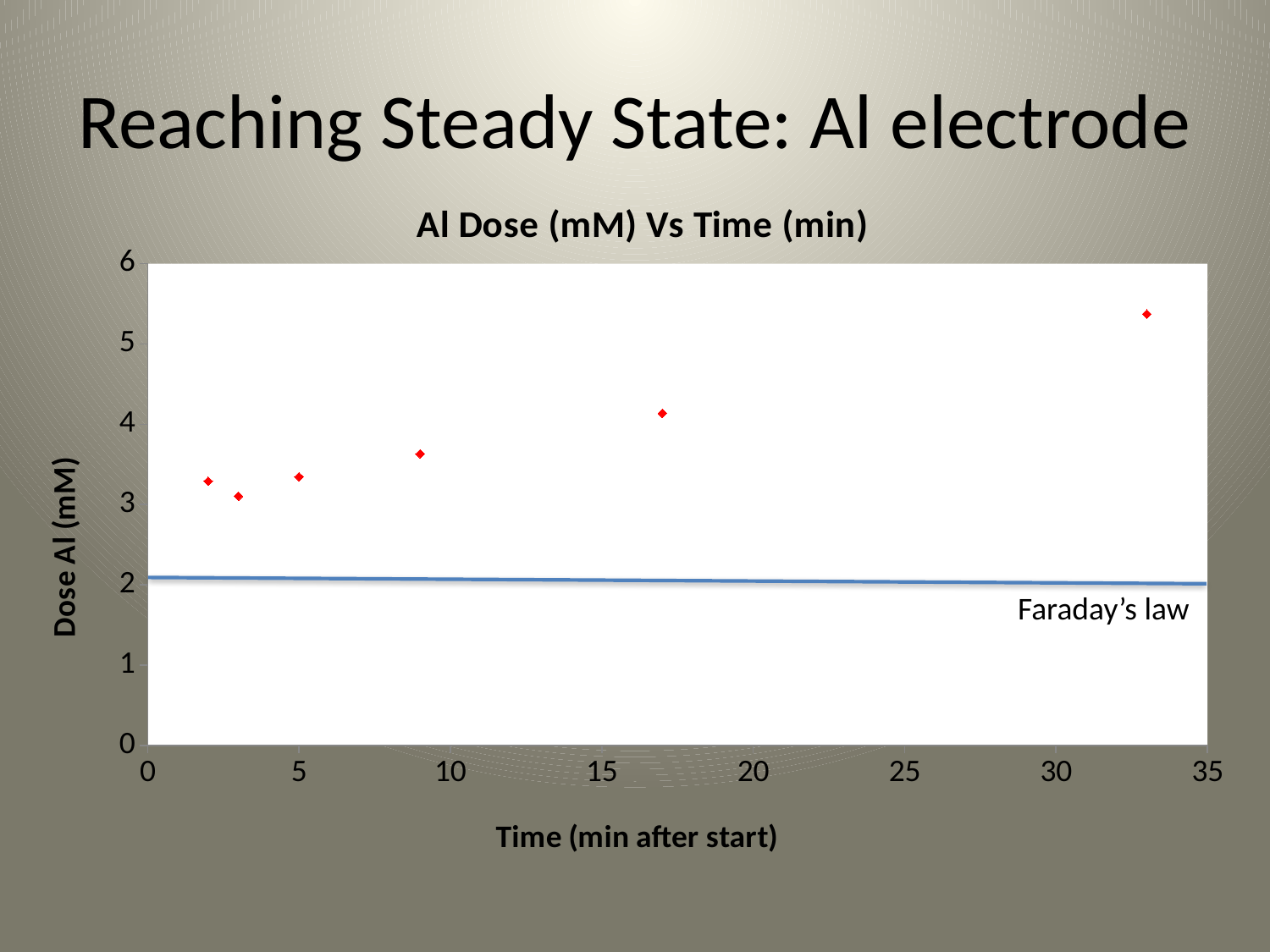
What is the label of the x axis? Time (min after start) Which is larger: the Al dose at about 17 minutes or the Al dose at about 9 minutes? 17 minutes What kind of chart is shown on the slide? scatter chart What is the title of the chart? Al Dose (mM) Vs Time (min) At which time (in minutes) is the plotted Al dose lowest? 3 At which time (in minutes) is the plotted Al dose highest? 33 Is the Faraday's law line greater or less than 3 mM across the chart? less Is the Al dose value at about 17 minutes greater or less than 4? greater How many red data points are plotted on the chart? 6 Do the plotted Al dose values generally rise or fall as time increases? rise Is the Al dose value at about 33 minutes greater or less than 5? greater